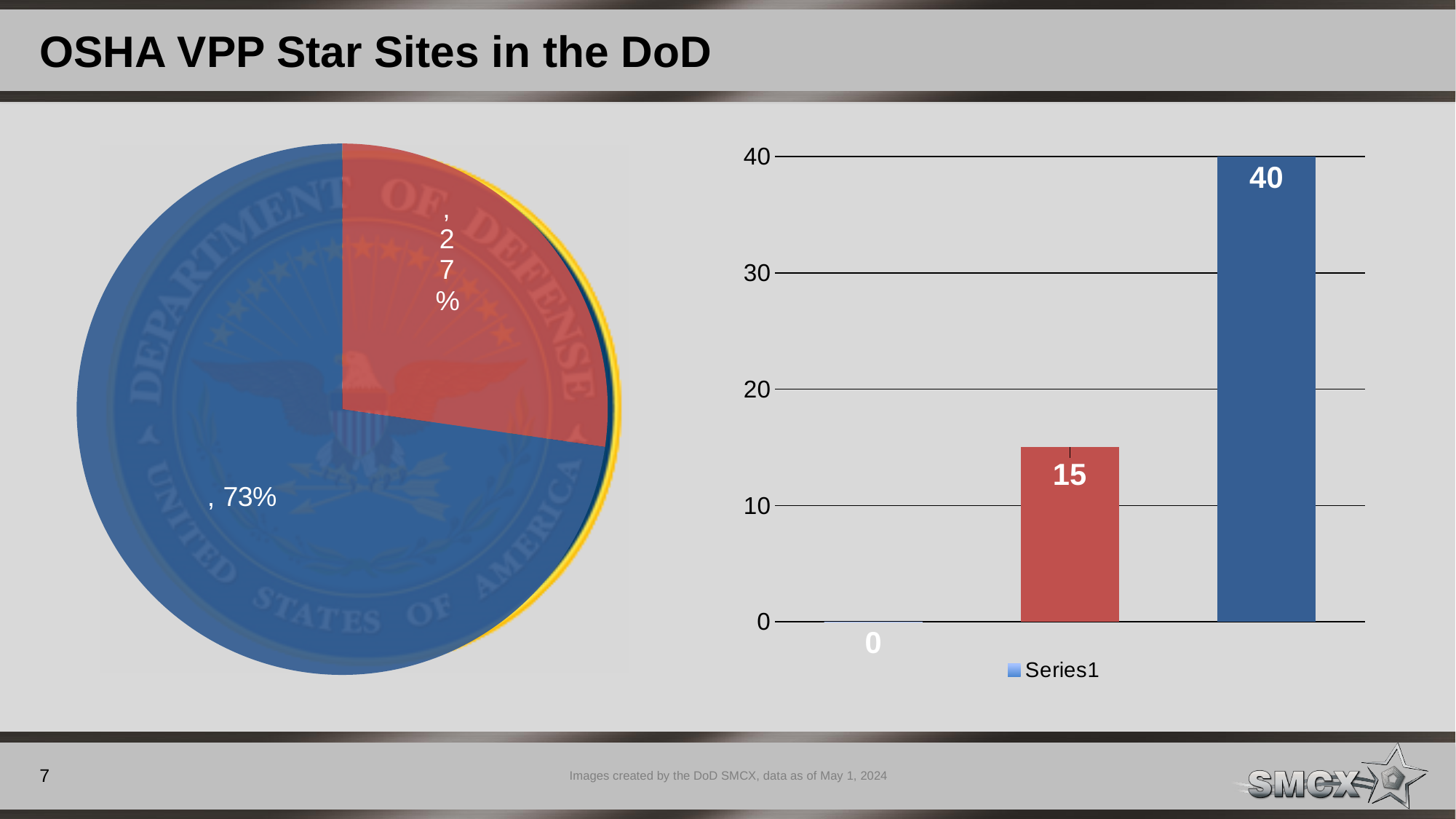
In the bar chart on the right, what is the value of the middle (red) bar? 15 What kind of chart is the chart on the left of the slide? pie chart In the bar chart on the right, how many bars are plotted? 3 In the pie chart on the left, which slice is larger, the blue one or the red one? the blue one In the bar chart on the right, what is the value of the tallest bar? 40 In the bar chart on the right, what is the value of the leftmost bar? 0 In the pie chart on the left, what share does the red slice represent? 27% In the bar chart on the right, what is the difference between the rightmost bar and the middle bar? 25 What kind of chart is the chart on the right of the slide? bar chart In the pie chart on the left, how many slices are there? 2 In the bar chart on the right, what entry does the legend show? Series1 In the pie chart on the left, what share does the blue slice represent? 73%